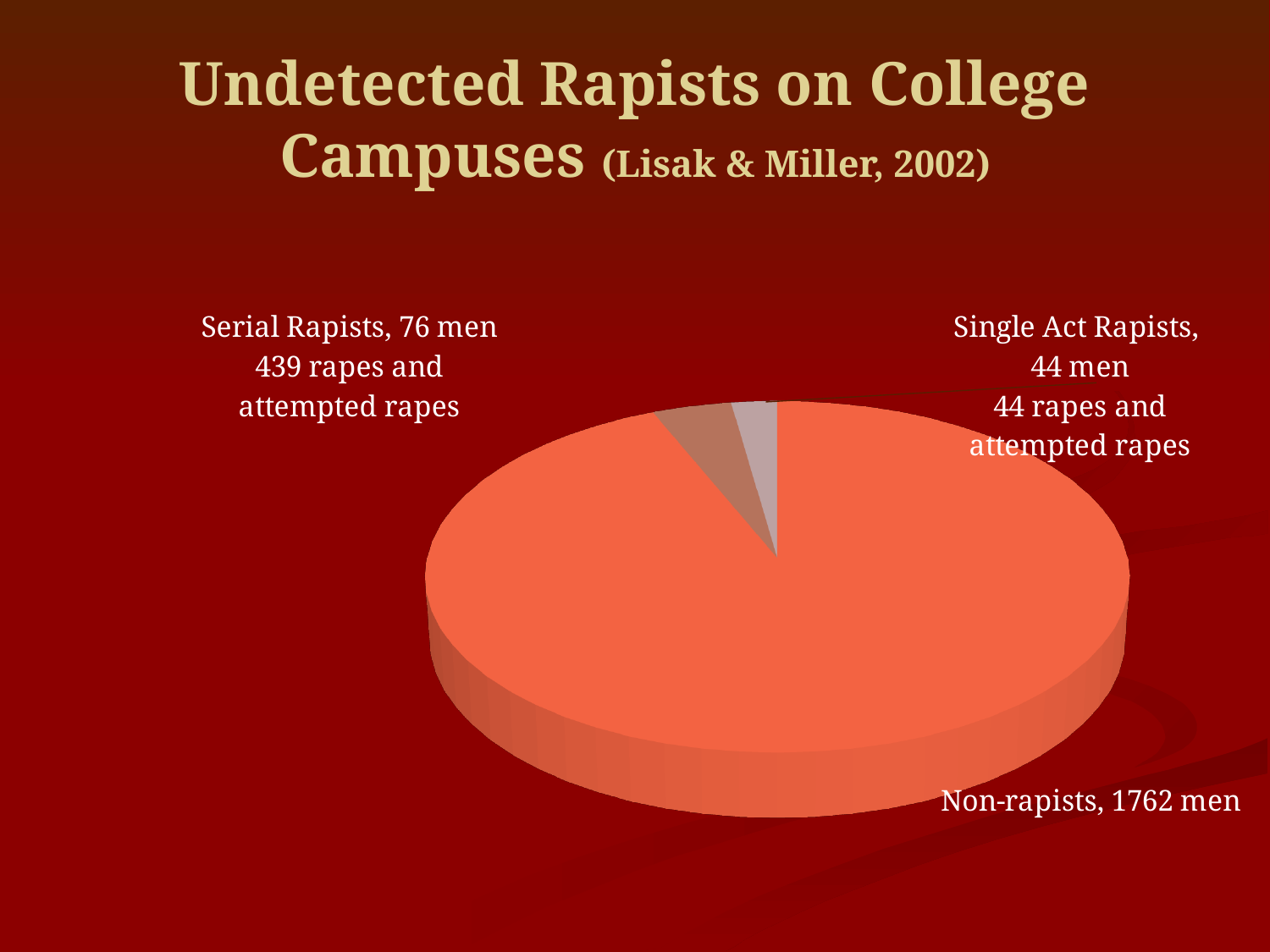
Which slice of the pie chart is the largest? Non-rapists How many men are in the Single Act Rapists slice? 44 men How many rapes and attempted rapes are attributed to the Serial Rapists group? 439 How many men are in the Serial Rapists slice? 76 men What is the difference in number of men between Non-rapists and Serial Rapists? 1686 What source is cited in the chart title? Lisak & Miller, 2002 What kind of chart is shown on the slide? pie chart How many slices does the pie chart have? 3 How many more men are Serial Rapists than Single Act Rapists? 32 How many men are in the Non-rapists slice? 1762 men Which slice of the pie chart is the smallest? Single Act Rapists Which group has more men, Serial Rapists or Single Act Rapists? Serial Rapists